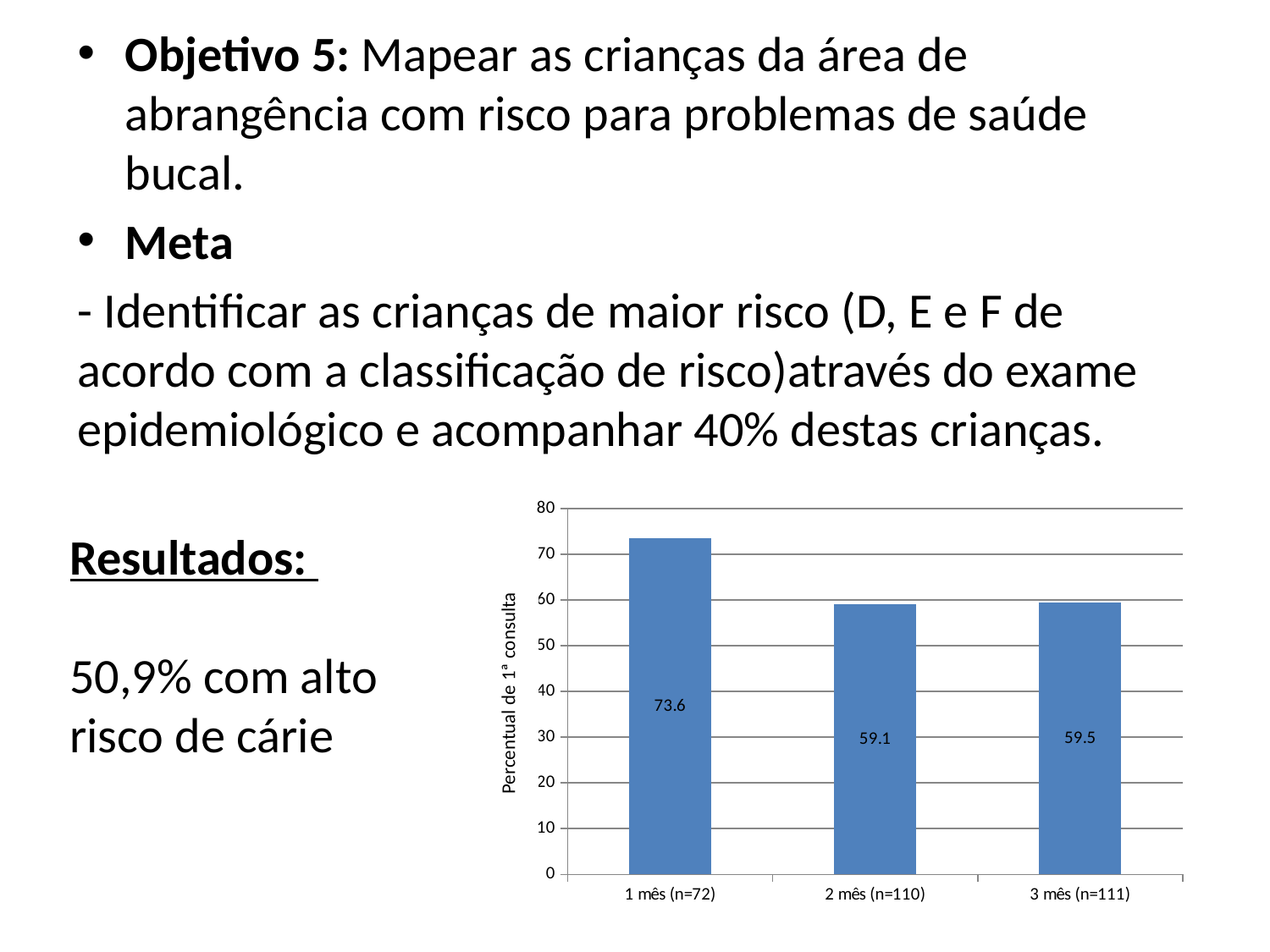
What value is shown for 2 mês (n=110)? 59.1 Which category has the lowest value? 2 mês (n=110) What value is shown for 1 mês (n=72)? 73.6 What is the label of the vertical axis of the chart? Percentual de 1ª consulta What kind of chart is shown on the slide? bar chart What value is shown for 3 mês (n=111)? 59.5 Which category has the highest value? 1 mês (n=72) What is the difference between the values for 1 mês (n=72) and 2 mês (n=110)? 14.5 What is the difference between the values for 1 mês (n=72) and 3 mês (n=111)? 14.1 Is the value for 1 mês (n=72) greater or less than 70? greater How many categories are shown on the x axis? 3 Which is larger, the value for 1 mês (n=72) or the value for 3 mês (n=111)? 1 mês (n=72)